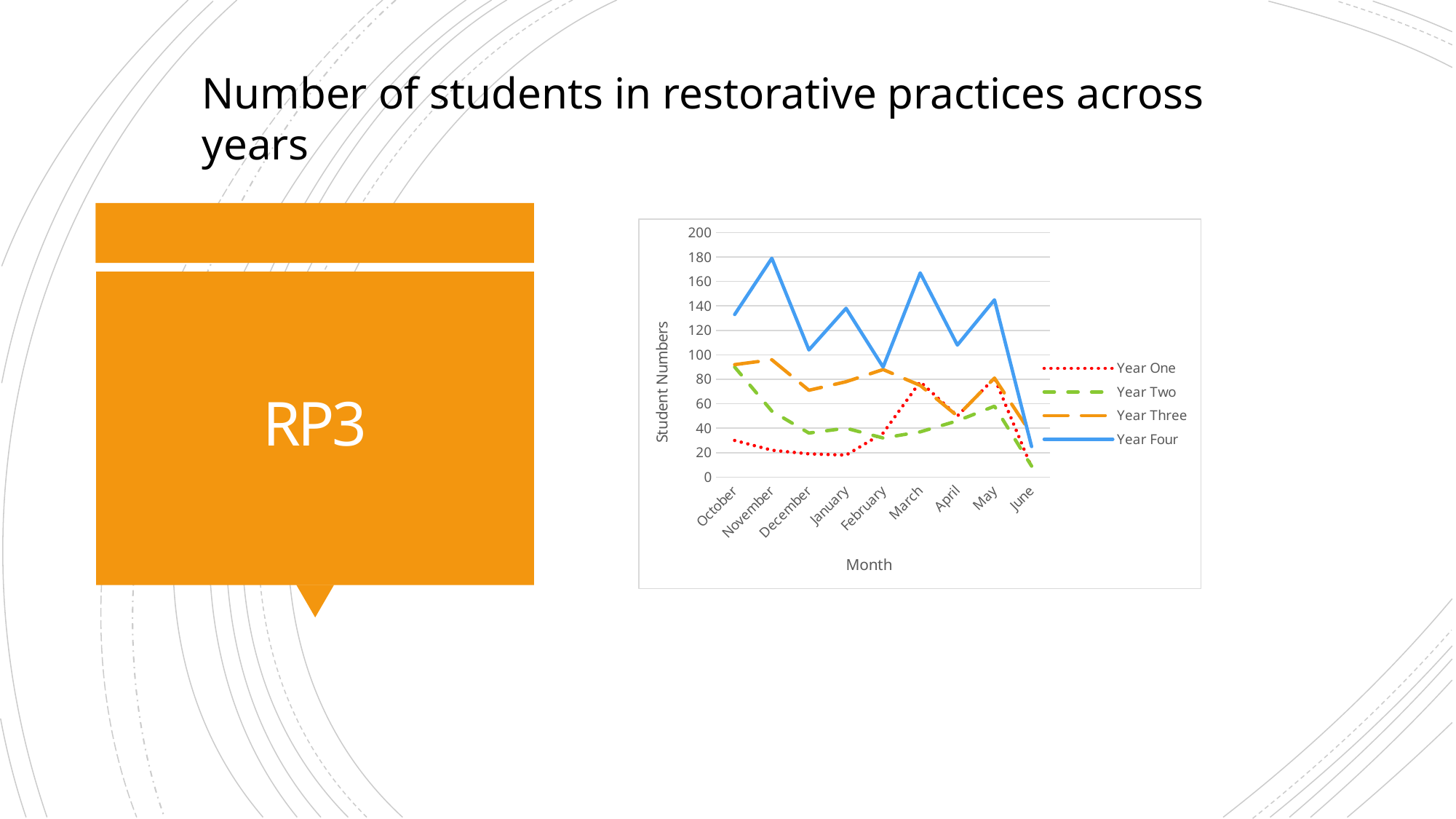
Is the value for Year Four in November greater or less than 160? greater How many series does the legend list? 4 What is the title of the vertical axis? Student Numbers Is the value for Year One in January greater or less than 40? less What kind of chart is shown on the slide? Line chart In which month does Year Two reach its lowest value? June Is the value for Year Three in December greater or less than 60? greater In October, which series has the larger value, Year Four or Year One? Year Four In which month does Year Four reach its highest value? November Does the Year Four line rise or fall from May to June? Falls How many months are plotted along the x axis? 9